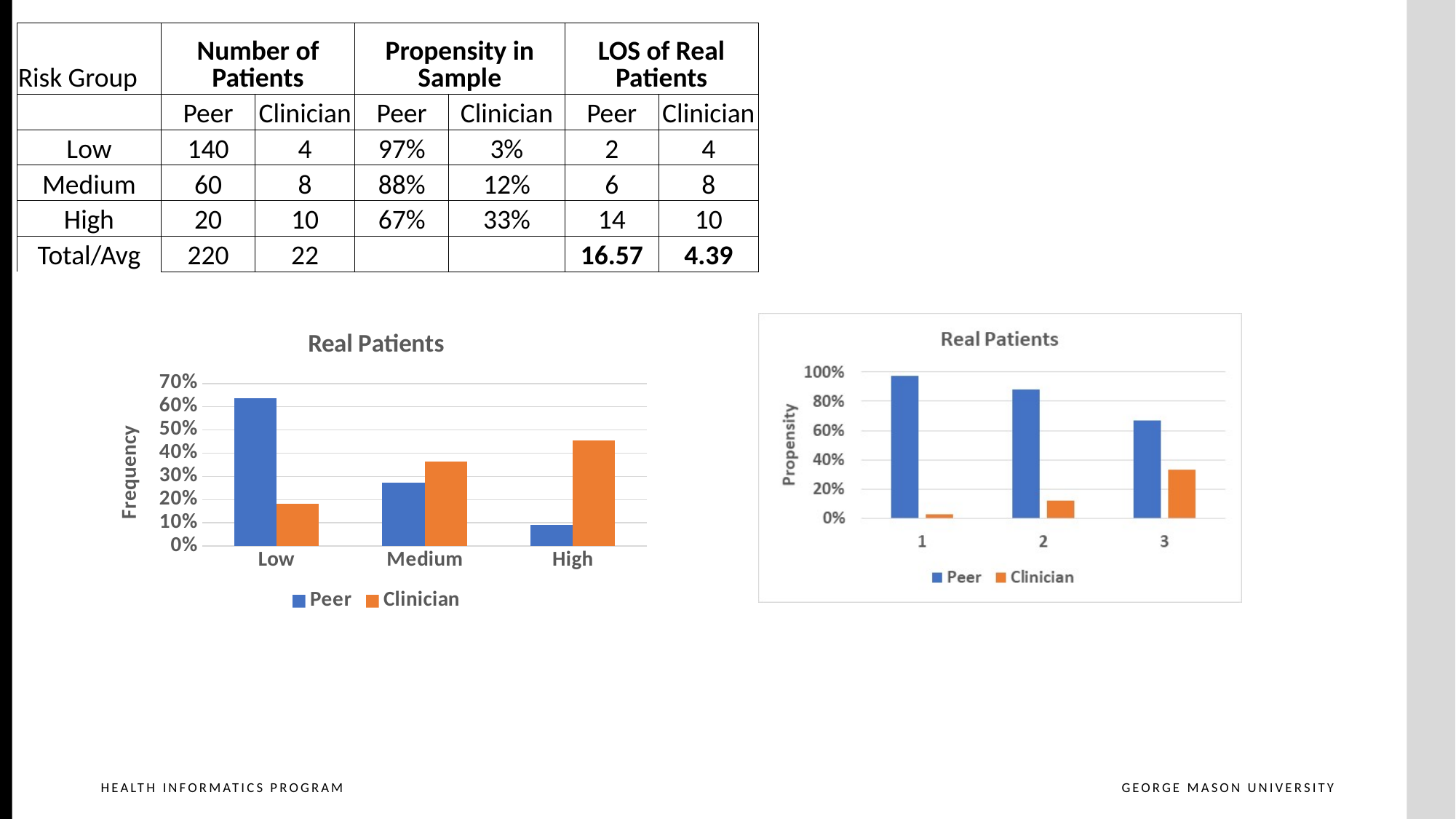
What kind of chart is the left chart titled "Real Patients"? bar chart In the left chart, which category has the lowest Peer value? High How many categories are shown on the x axis of the left chart? 3 In the right chart, which category has the highest Clinician value? 3 In the left chart, is the Peer value for Low greater or less than 60%? greater In the left chart, for the Medium category, which is larger: Peer or Clinician? Clinician In the left chart, is the Clinician value for High greater or less than 40%? greater In the right chart, is the Peer value for category 1 greater or less than 90%? greater How many series does the legend of the left chart list? 2 What is the y-axis label of the right chart? Propensity In the right chart, do the Peer values rise or fall from category 1 to category 3? fall In the left chart, which category has the highest Peer value? Low